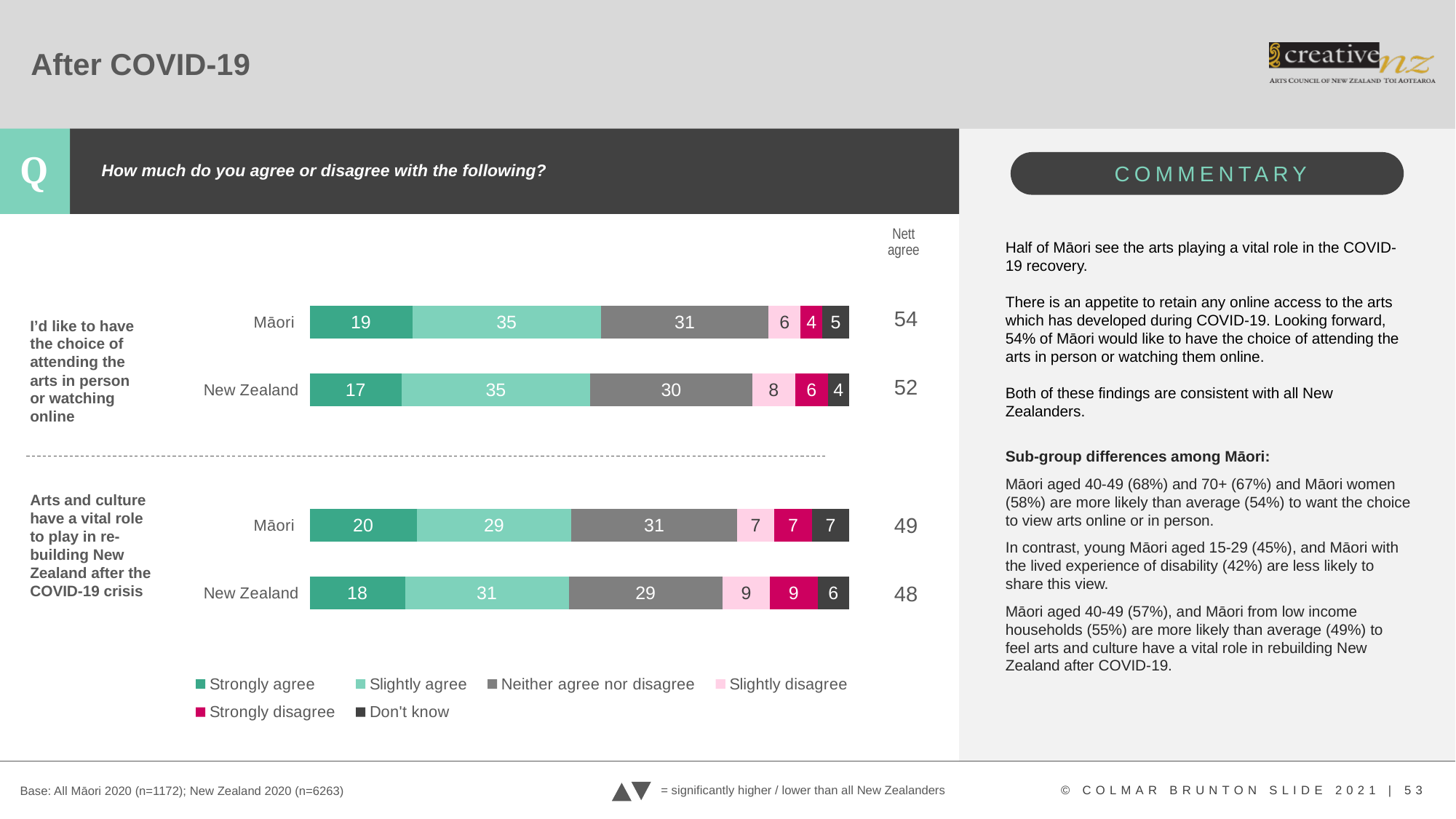
What kind of chart is shown on the slide? Stacked bar chart What is the Nett agree figure for Māori on 'Arts and culture have a vital role to play in re-building New Zealand after the COVID-19 crisis'? 49 What is the total of the 'Strongly agree' and 'Slightly agree' segments for New Zealand on 'Arts and culture have a vital role to play in re-building New Zealand after the COVID-19 crisis'? 49 Which is larger: the 'Strongly agree' value for Māori or for New Zealand on 'Arts and culture have a vital role to play in re-building New Zealand after the COVID-19 crisis'? Māori What is the difference between the Nett agree figures for Māori and New Zealand on 'I'd like to have the choice of attending the arts in person or watching online'? 2 How many bars are plotted on the chart in total? 4 What is the 'Strongly agree' value for Māori on 'I'd like to have the choice of attending the arts in person or watching online'? 19 What is the 'Neither agree nor disagree' value for New Zealand on 'Arts and culture have a vital role to play in re-building New Zealand after the COVID-19 crisis'? 29 What is the 'Don't know' value for Māori on 'Arts and culture have a vital role to play in re-building New Zealand after the COVID-19 crisis'? 7 Which response category has the lowest value for Māori on 'I'd like to have the choice of attending the arts in person or watching online'? Strongly disagree How many series does the legend list? 6 Which response category has the highest value for New Zealand on 'I'd like to have the choice of attending the arts in person or watching online'? Slightly agree